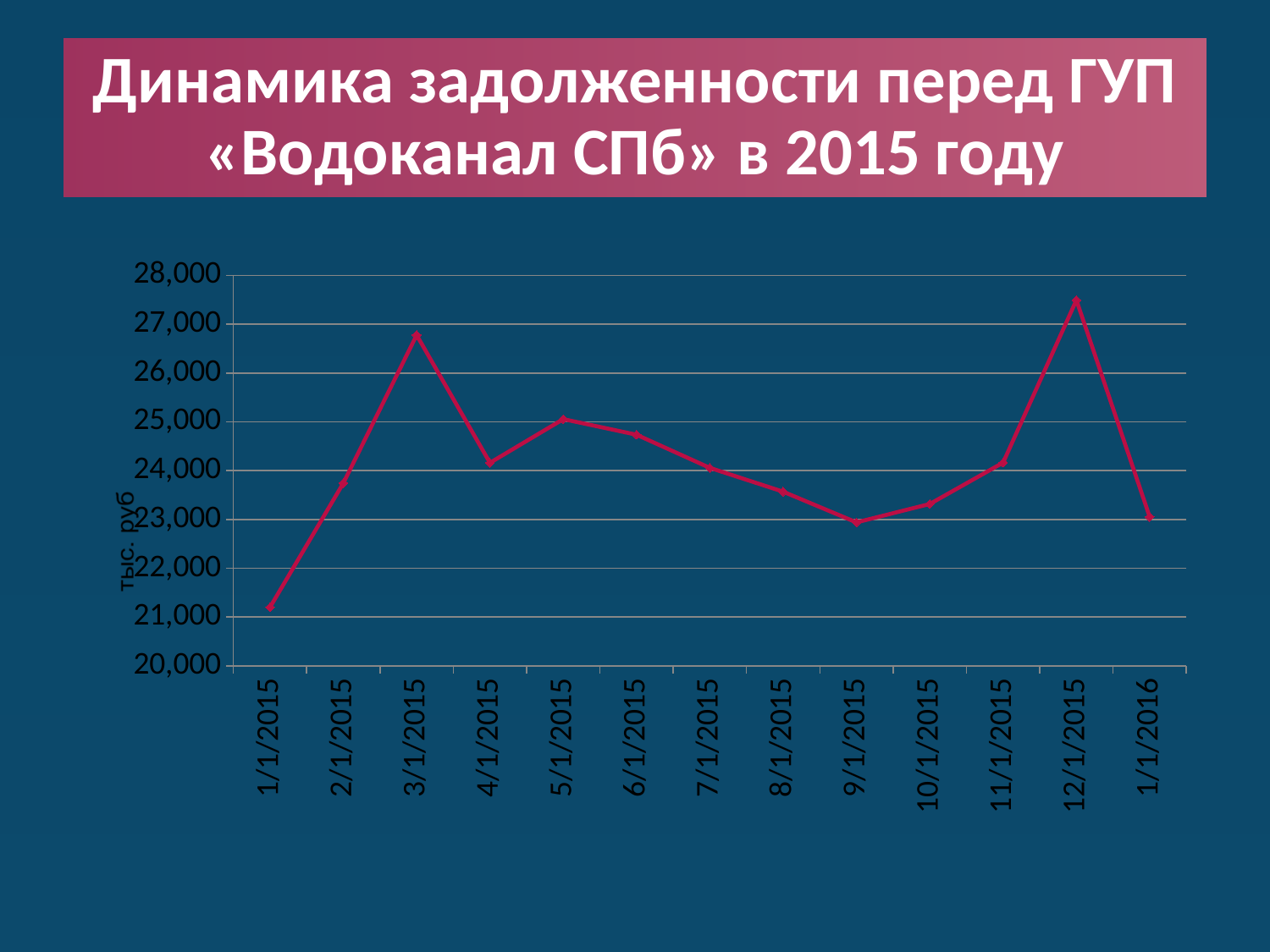
On which date does the debt reach its highest value? 12/1/2015 How many data points are plotted on the line? 13 On which date is the debt at its lowest value? 1/1/2015 What unit is shown on the vertical axis label? тыс. руб Does the value rise or fall from 9/1/2015 to 12/1/2015? rise Is the value for 1/1/2015 greater or less than 22,000? less Is the value for 8/1/2015 greater or less than 24,000? less Does the value rise or fall from 3/1/2015 to 4/1/2015? fall Is the value for 3/1/2015 greater or less than 26,000? greater Which is larger, the value for 6/1/2015 or the value for 10/1/2015? 6/1/2015 What kind of chart is shown on the slide? line chart